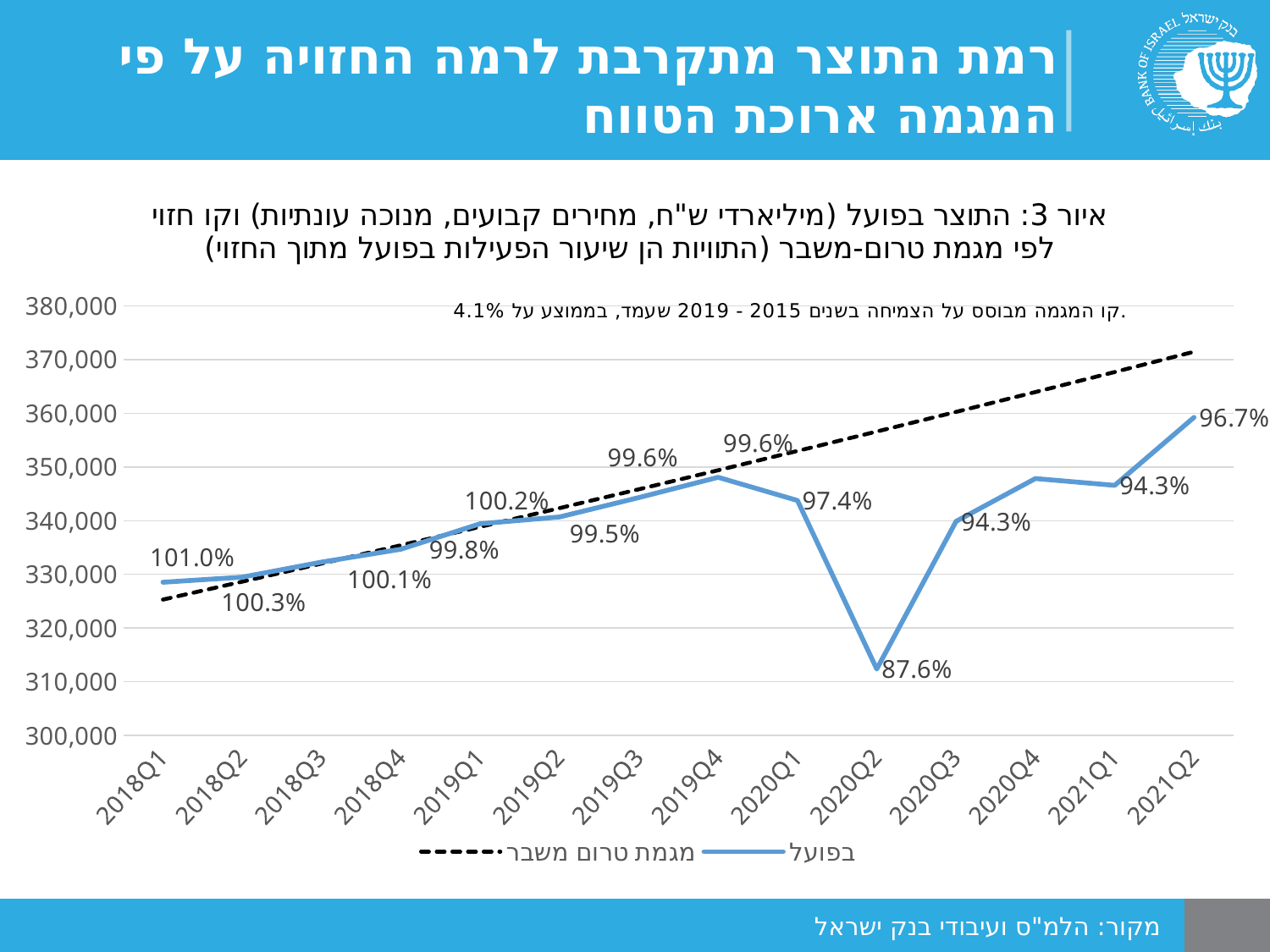
Does the dashed pre-crisis trend line (מגמת טרום משבר) rise or fall from 2018Q1 to 2021Q2? rise What is the data label shown for 2020Q2 on the actual (בפועל) line? 87.6% Which is larger, the actual (בפועל) value for 2019Q4 or for 2020Q2? 2019Q4 What is the data label shown for 2018Q1 on the actual (בפועל) line? 101.0% What is the data label shown for 2021Q2 on the actual (בפועל) line? 96.7% Is the actual (בפועל) value for 2021Q2 greater or less than 350,000? greater Is the actual (בפועל) value for 2020Q2 greater or less than 320,000? less What is the data label shown for 2020Q1 on the actual (בפועל) line? 97.4% What kind of chart is shown on the slide? line chart Which quarter has the lowest data label on the actual (בפועל) line? 2020Q2 How many series does the legend list? 2 How many quarters are shown on the x axis? 14